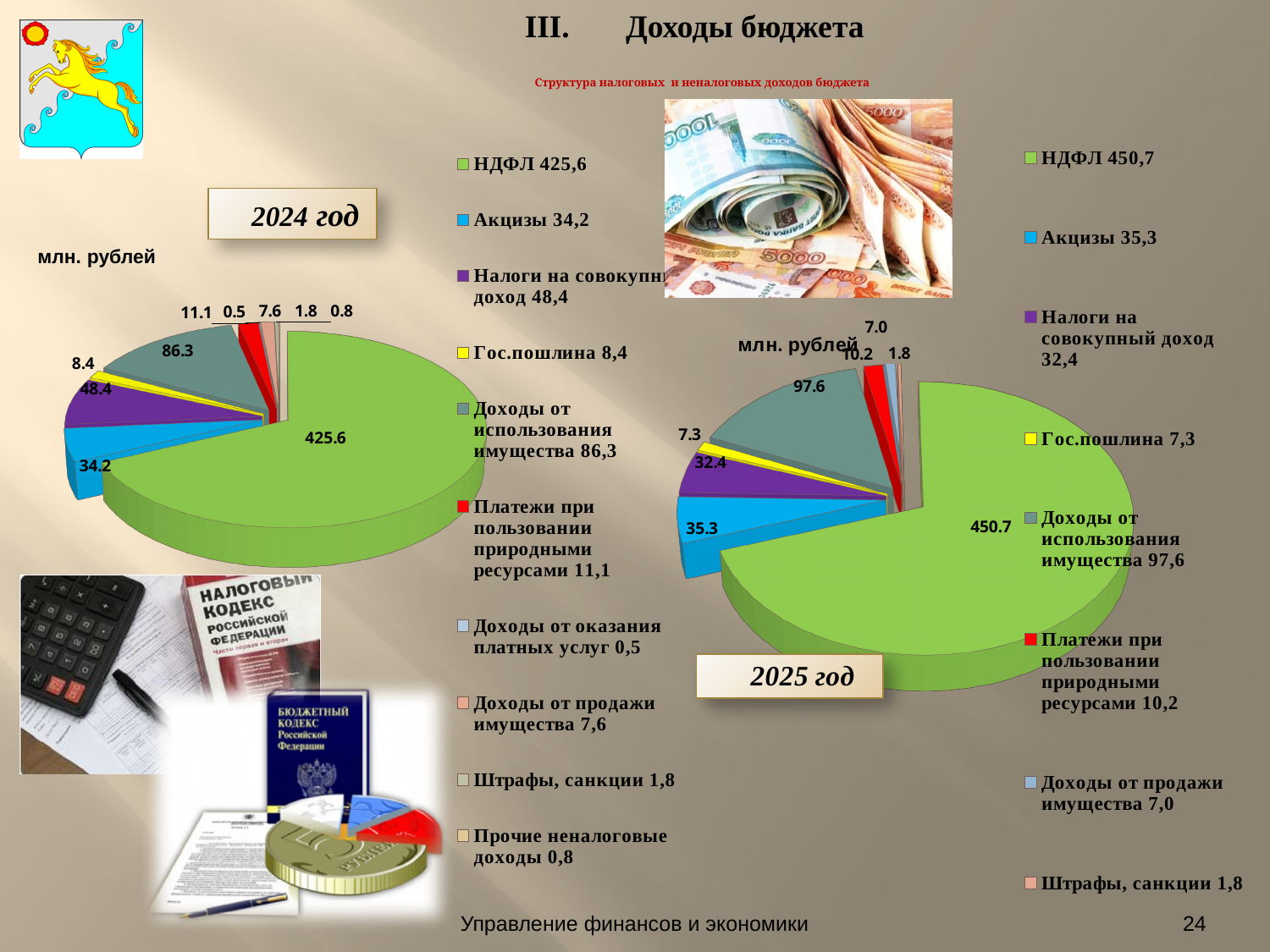
On the 2024 год pie chart, which category has the smallest value? Доходы от оказания платных услуг On the 2025 год pie chart, which category has the smallest value? Штрафы, санкции On the 2024 год pie chart, what is the value for НДФЛ? 425.6 What is the difference between НДФЛ on the 2025 год chart and НДФЛ on the 2024 год chart? 25.1 On the 2024 год pie chart, which is larger: Акцизы or Налоги на совокупный доход? Налоги на совокупный доход On the 2025 год pie chart, which category has the largest value? НДФЛ How many categories does the 2024 год pie chart show? 10 How many categories does the 2025 год pie chart show? 8 On the 2025 год pie chart, what is the value for Доходы от использования имущества? 97.6 On the 2025 год pie chart, what is the value for Акцизы? 35.3 What type of chart is used for the 2025 год data? Pie chart On the 2024 год pie chart, what is the value for Налоги на совокупный доход? 48.4